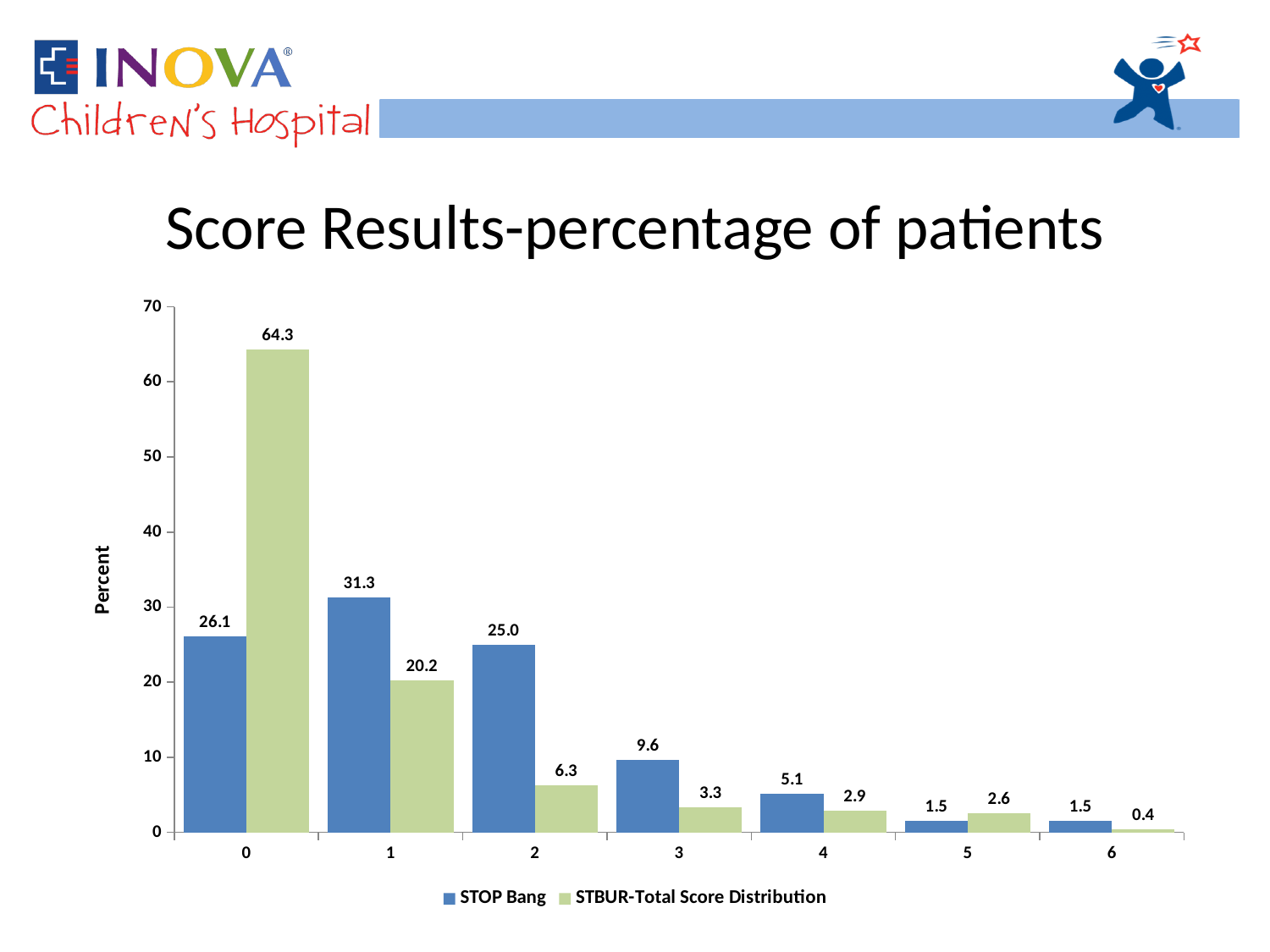
What kind of chart is shown on the slide? bar chart What is the STBUR-Total Score Distribution value for score 0? 64.3 How many series does the legend list? 2 Which score has the lowest STBUR-Total Score Distribution value? 6 What is the STBUR-Total Score Distribution value for score 6? 0.4 What is the STOP Bang value for score 1? 31.3 What is the difference between the STBUR-Total Score Distribution and STOP Bang values for score 0? 38.2 How many score categories are shown on the x axis? 7 For score 2, which series has the larger value, STOP Bang or STBUR-Total Score Distribution? STOP Bang Which score has the highest STOP Bang value? 1 What is the STOP Bang value for score 3? 9.6 What is the label of the y axis? Percent